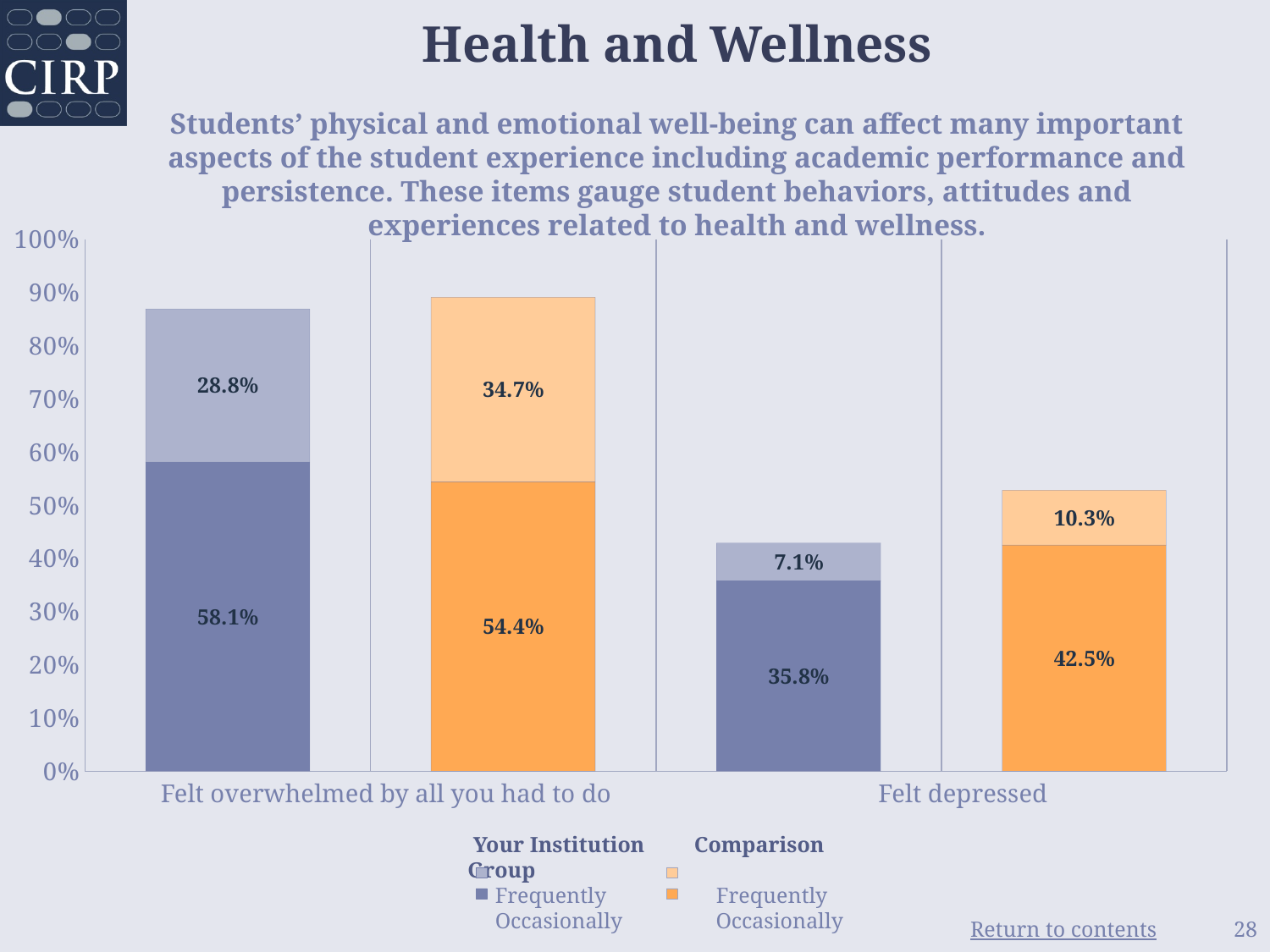
What is the title of the slide containing the chart? Health and Wellness What percentage of students at Your Institution frequently felt overwhelmed by all they had to do? 28.8% Which is larger: the percentage of Your Institution students who frequently felt overwhelmed, or the percentage of Comparison Group students who frequently felt overwhelmed? Comparison Group What is the total percentage of Your Institution students who frequently or occasionally felt overwhelmed by all they had to do? 86.9% How many categories are shown on the x axis of the chart? 2 What percentage of students in the Comparison Group occasionally felt overwhelmed by all they had to do? 54.4% Is the total stacked bar for Your Institution for 'Felt depressed' greater or less than 50%? less What is the difference between the Comparison Group and Your Institution in the percentage of students who frequently felt depressed? 3.2% What percentage of students in the Comparison Group frequently felt depressed? 10.3% What kind of chart is shown on the slide? stacked bar chart What percentage of students at Your Institution occasionally felt depressed? 35.8% What is the total percentage of Comparison Group students who frequently or occasionally felt depressed? 52.8%